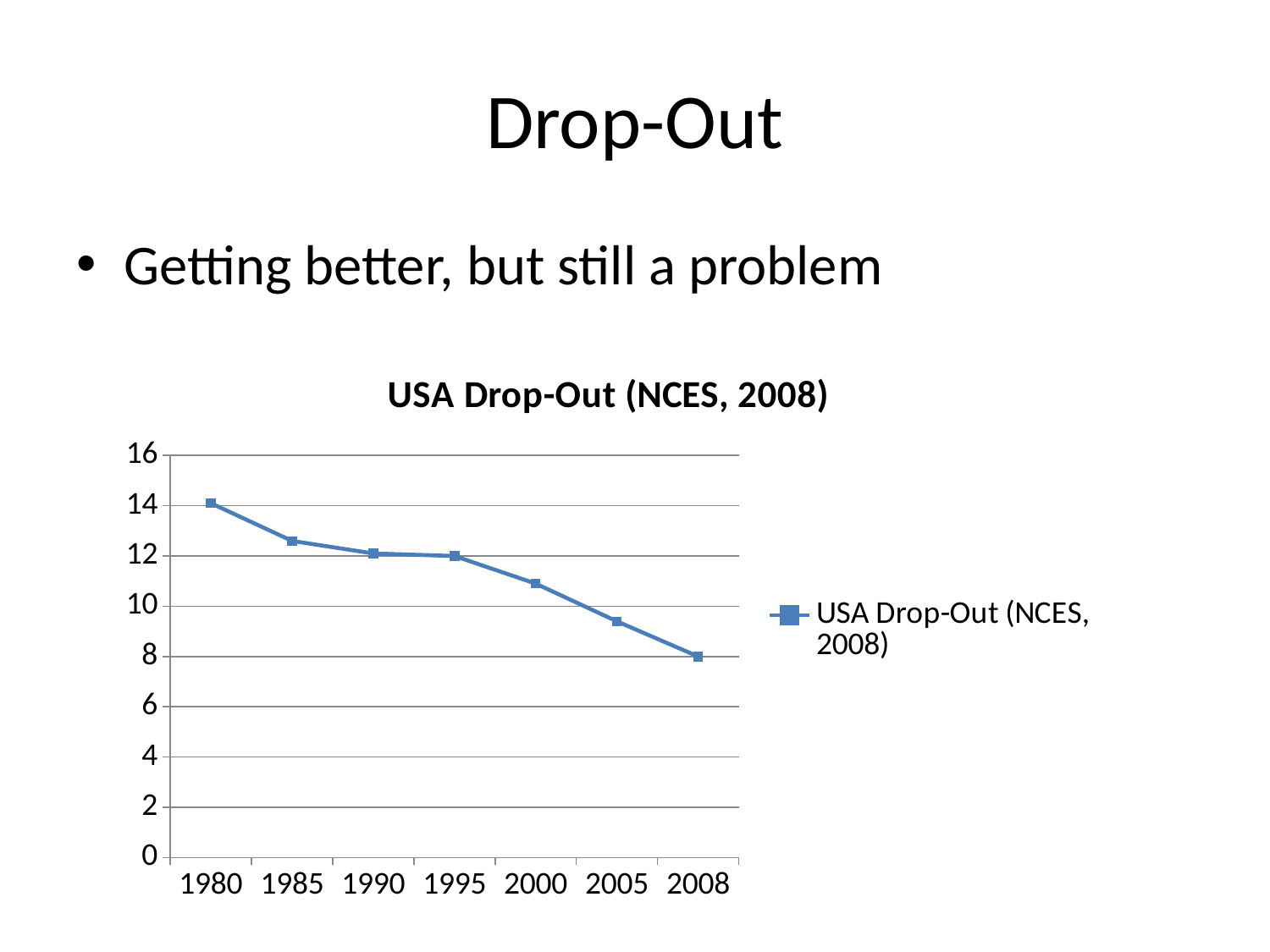
How many data points are plotted on the line? 7 Do the values rise or fall from 1980 to 2008? fall Which is larger, the value for 1985 or the value for 2005? 1985 Which year has the lowest drop-out value? 2008 Is the value for 2000 greater or less than 10? greater Is the value for 2005 greater or less than 10? less What is the first year shown on the x axis? 1980 What is the title of the chart? USA Drop-Out (NCES, 2008) Is the value for 1980 greater or less than 12? greater What type of chart is shown on the slide? line chart How many series does the legend list? 1 Which year has the highest drop-out value? 1980